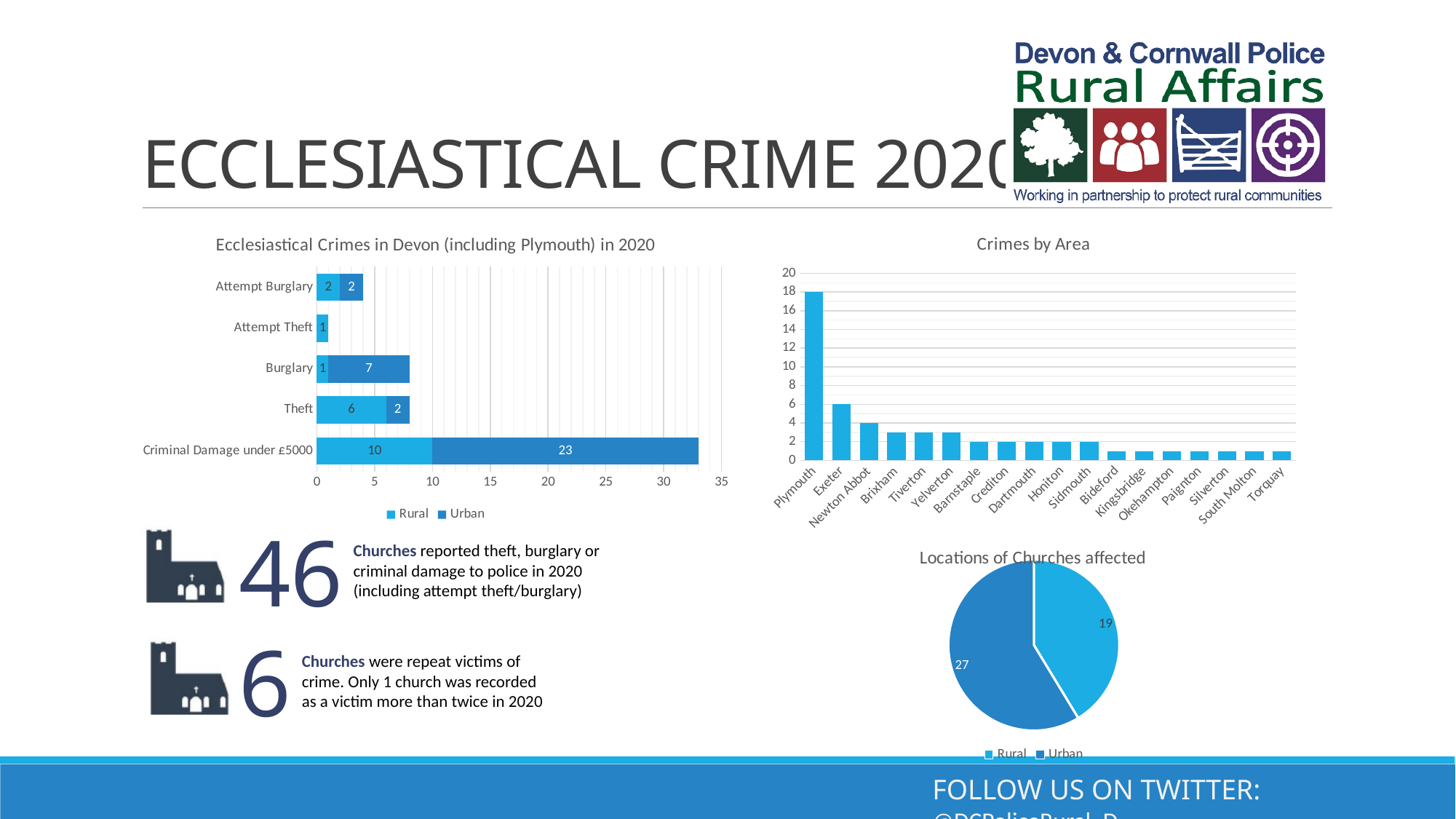
In the 'Crimes by Area' chart, how many areas are shown on the x axis? 18 In the 'Ecclesiastical Crimes in Devon (including Plymouth) in 2020' chart, which category has the highest total? Criminal Damage under £5000 In the 'Ecclesiastical Crimes in Devon (including Plymouth) in 2020' chart, how many series does the legend list? 2 In the 'Crimes by Area' chart, what is the value for Plymouth? 18 In the 'Ecclesiastical Crimes in Devon (including Plymouth) in 2020' chart, what is the Rural value for Theft? 6 In the 'Locations of Churches affected' pie chart, what is the value of the Rural slice? 19 In the 'Ecclesiastical Crimes in Devon (including Plymouth) in 2020' chart, what is the Urban value for Criminal Damage under £5000? 23 In the 'Ecclesiastical Crimes in Devon (including Plymouth) in 2020' chart, what is the difference between the Urban and Rural values for Criminal Damage under £5000? 13 In the 'Crimes by Area' chart, what is the value for Exeter? 6 In the 'Locations of Churches affected' pie chart, which slice is larger, Rural or Urban? Urban In the 'Ecclesiastical Crimes in Devon (including Plymouth) in 2020' chart, what is the total of the stacked bar for Burglary? 8 In the 'Crimes by Area' chart, is the value for Brixham greater or less than 4? less